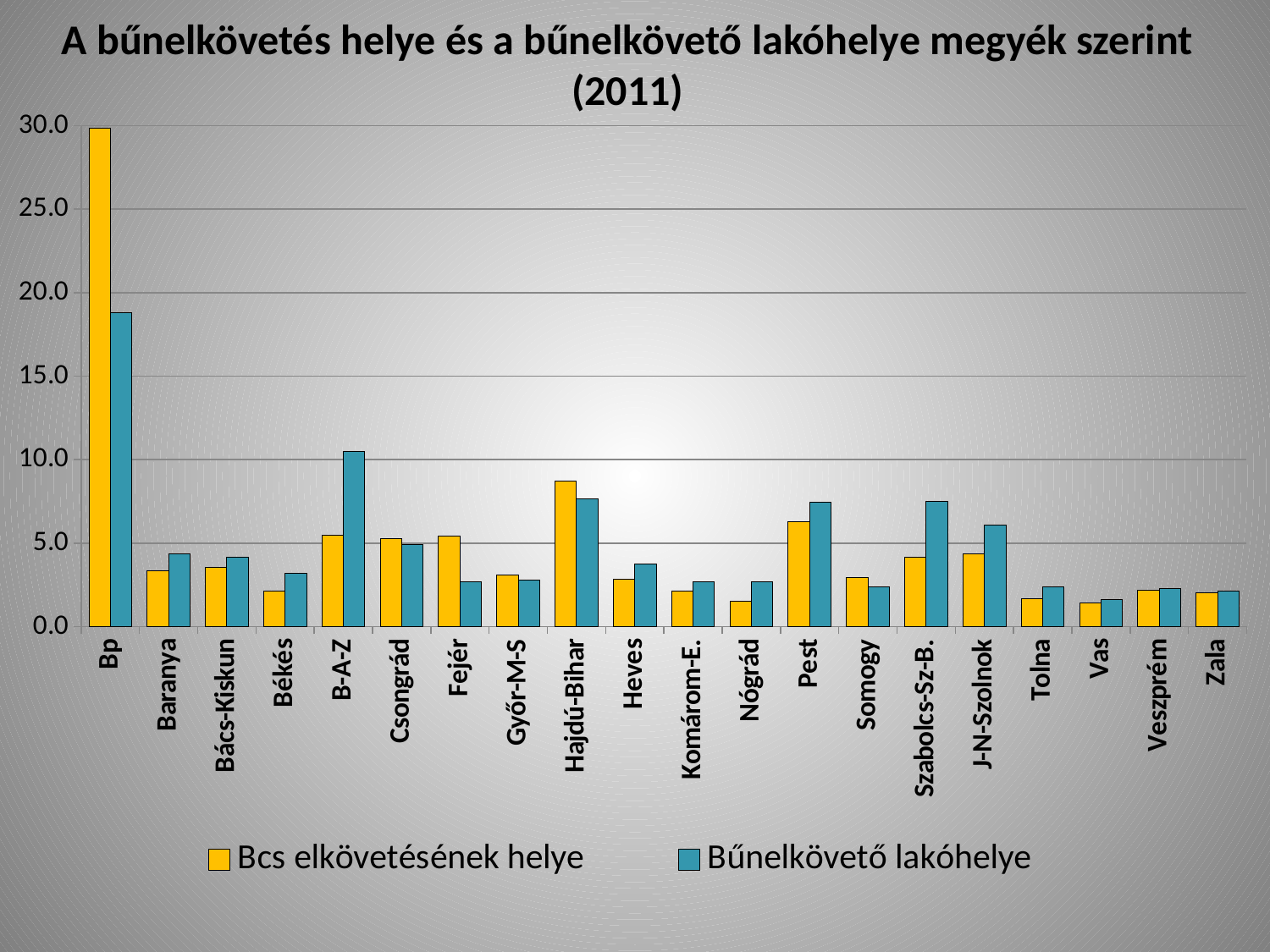
Is the value for Bp in the 'Bűnelkövető lakóhelye' series greater or less than 20.0? less Which category has the highest value for 'Bcs elkövetésének helye'? Bp Is the value for Hajdú-Bihar in the 'Bcs elkövetésének helye' series greater or less than 5.0? greater Is the value for Bp in the 'Bcs elkövetésének helye' series greater or less than 25.0? greater Which category has the highest value for 'Bűnelkövető lakóhelye'? Bp For B-A-Z, which series has the larger value: 'Bcs elkövetésének helye' or 'Bűnelkövető lakóhelye'? Bűnelkövető lakóhelye How many counties (categories) are shown on the x axis? 20 For Fejér, which series has the larger value: 'Bcs elkövetésének helye' or 'Bűnelkövető lakóhelye'? Bcs elkövetésének helye What is the title of the chart? A bűnelkövetés helye és a bűnelkövető lakóhelye megyék szerint (2011) What type of chart is shown on the slide? bar chart How many series does the legend list? 2